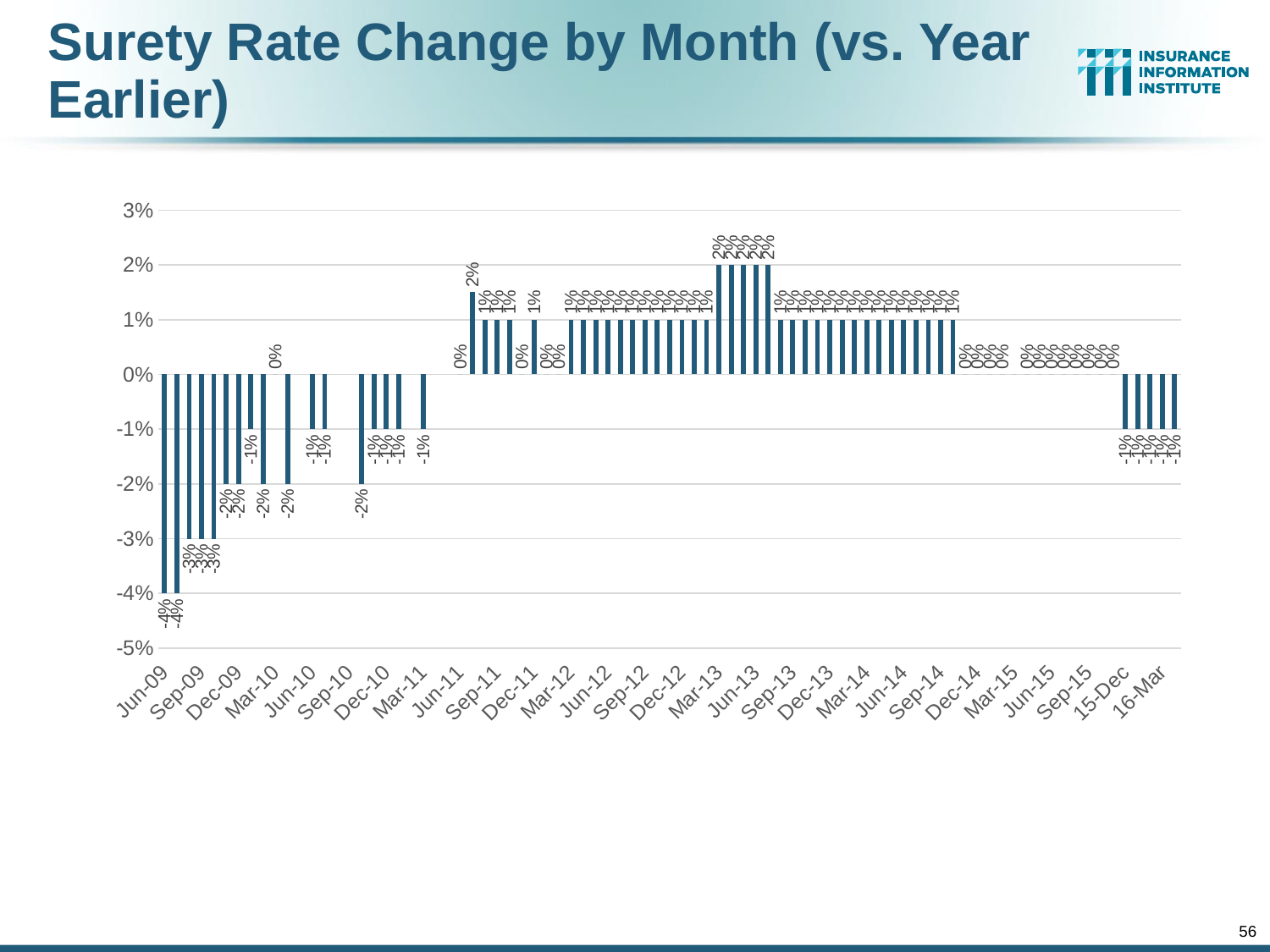
What is the surety rate change for Jun-09, the first month on the chart? -4% What is the surety rate change for 16-Mar, the last month on the chart? -1% What is the difference between the value for 16-Mar and the value for Jun-09? 3% What is the lowest value shown on the vertical axis? -5% What is the highest value shown on the chart? 2% Do the values generally rise or fall from Jun-09 to mid-2013? rise What kind of chart is shown on the slide? bar chart Is the value for Jun-09 greater or less than -3%? less What is the lowest value shown on the chart? -4% What is the title of the chart? Surety Rate Change by Month (vs. Year Earlier) Which is larger, the value for Jun-09 or the value for 16-Mar? 16-Mar Is the value for 16-Mar greater or less than 0%? less